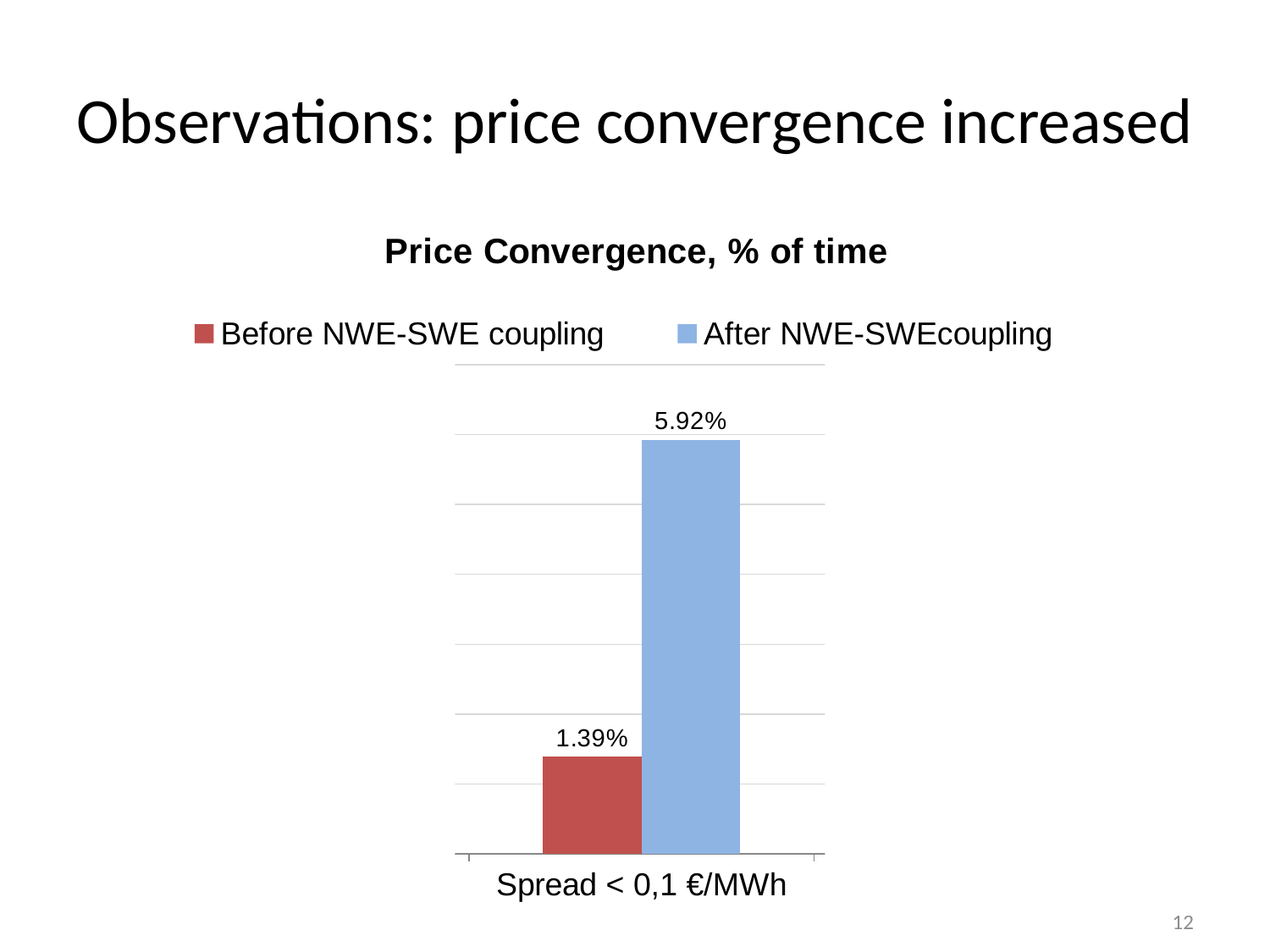
What is the category label on the x axis? Spread < 0,1 €/MWh How many categories are shown on the x axis? 1 What is the title of the chart? Price Convergence, % of time What is the value for Before NWE-SWE coupling? 1.39% Is the value for Before NWE-SWE coupling larger or smaller than the value for After NWE-SWEcoupling? smaller Which series has the lower value? Before NWE-SWE coupling What is the value for After NWE-SWEcoupling? 5.92% How many series does the legend list? 2 Which series has the higher value? After NWE-SWEcoupling What is the difference between the After NWE-SWEcoupling value and the Before NWE-SWE coupling value? 4.53% What kind of chart is shown? bar chart